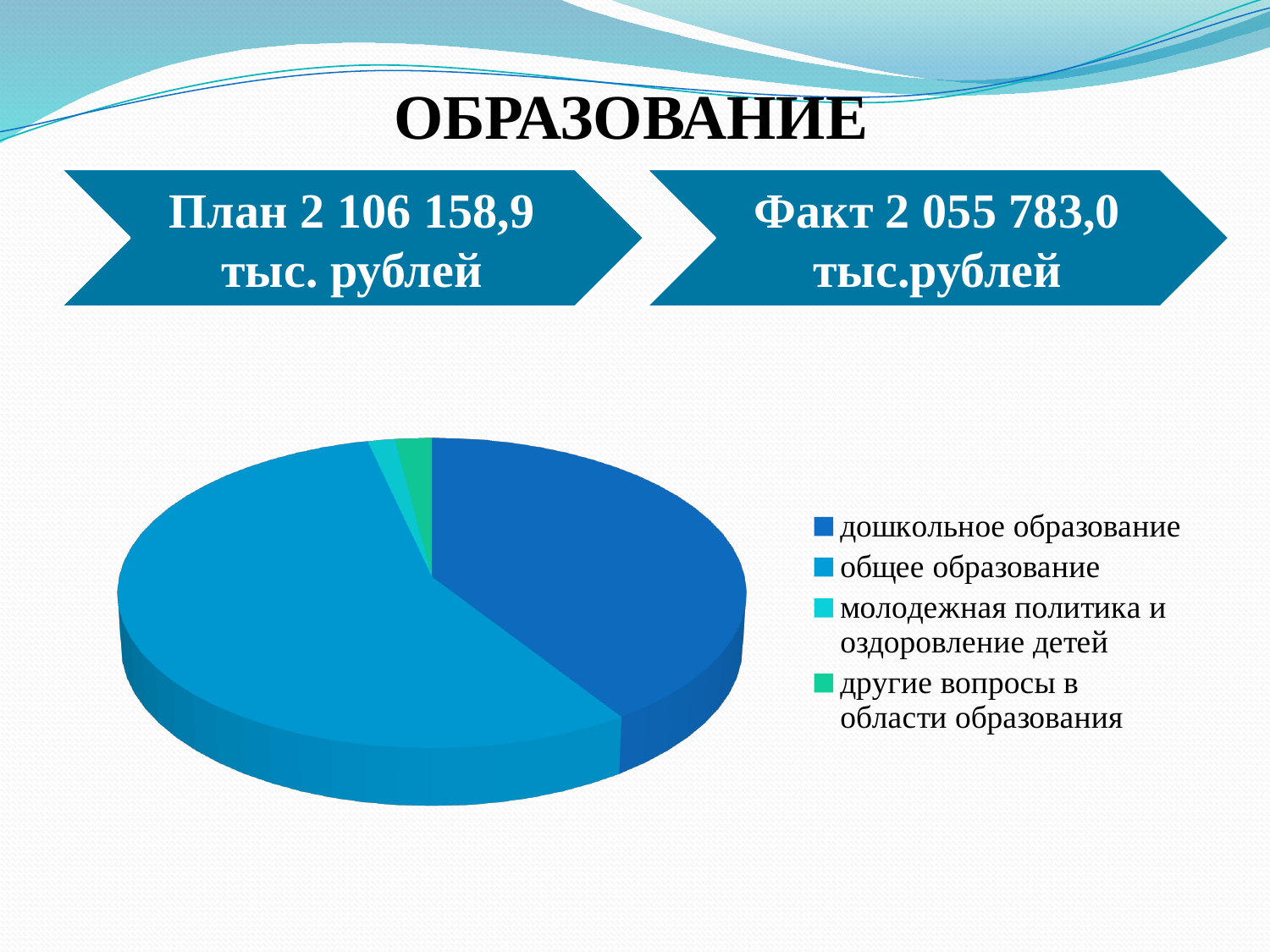
How many entries does the legend of the pie chart list? 4 Which slice is larger: общее образование or другие вопросы в области образования? общее образование How many slices does the pie chart have? 4 Which slice is larger: дошкольное образование or молодежная политика и оздоровление детей? дошкольное образование Which category has the largest slice in the pie chart? общее образование What is the title of the slide containing the pie chart? ОБРАЗОВАНИЕ What kind of chart is shown on the slide? pie chart Which slice is larger: общее образование or дошкольное образование? общее образование Which legend entry is shown in green in the pie chart? другие вопросы в области образования